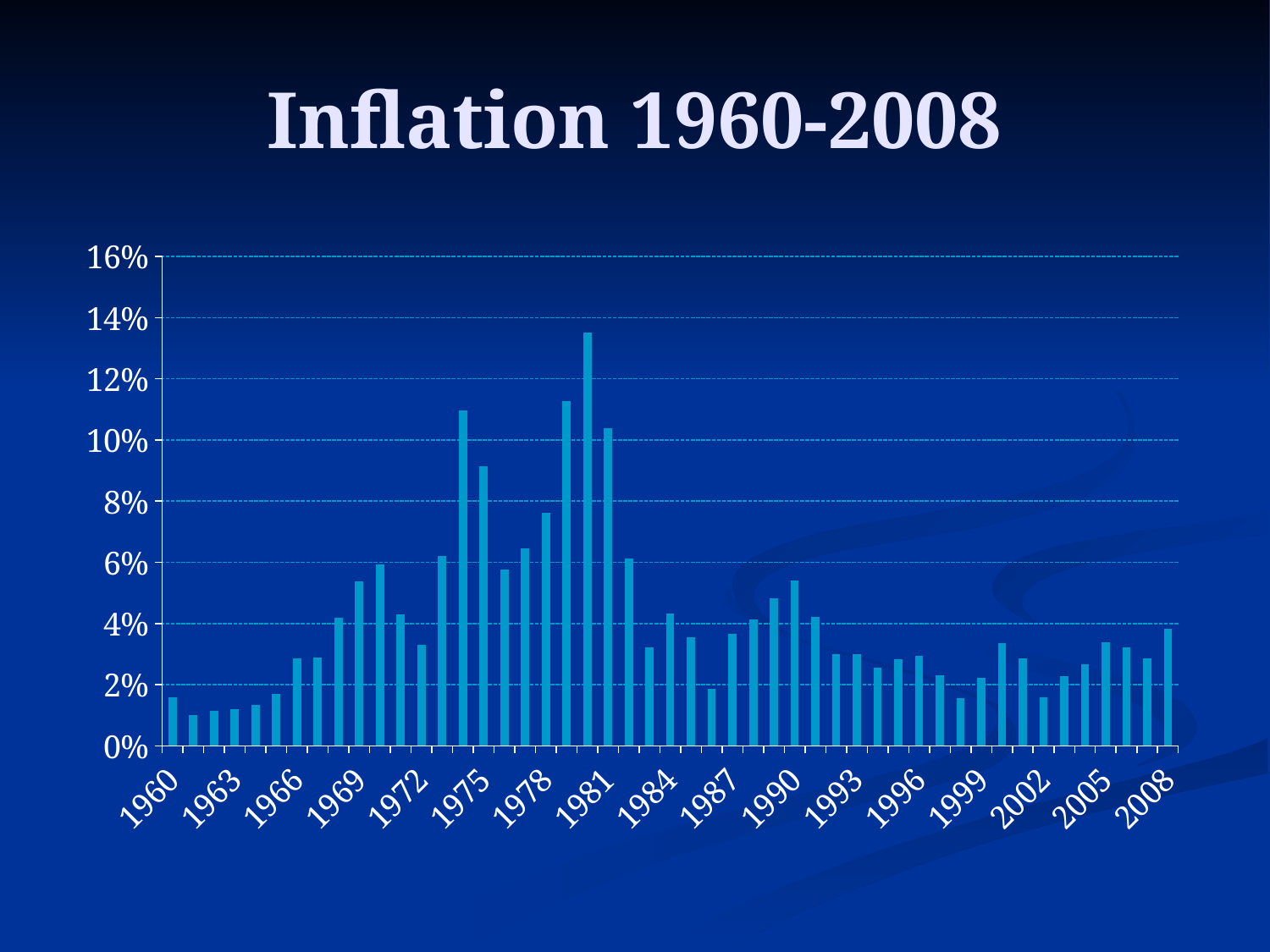
What is the title of the chart? Inflation 1960-2008 What kind of chart is shown on the slide? bar chart Which year has the higher inflation value, 1975 or 1978? 1975 Is the inflation value for 1969 greater or less than 4%? greater Is the inflation value for 1960 greater or less than 2%? less Is the tallest bar on the chart greater or less than 12%? greater Which year has the higher inflation value, 1963 or 1969? 1969 What is the highest value shown on the vertical axis? 16%